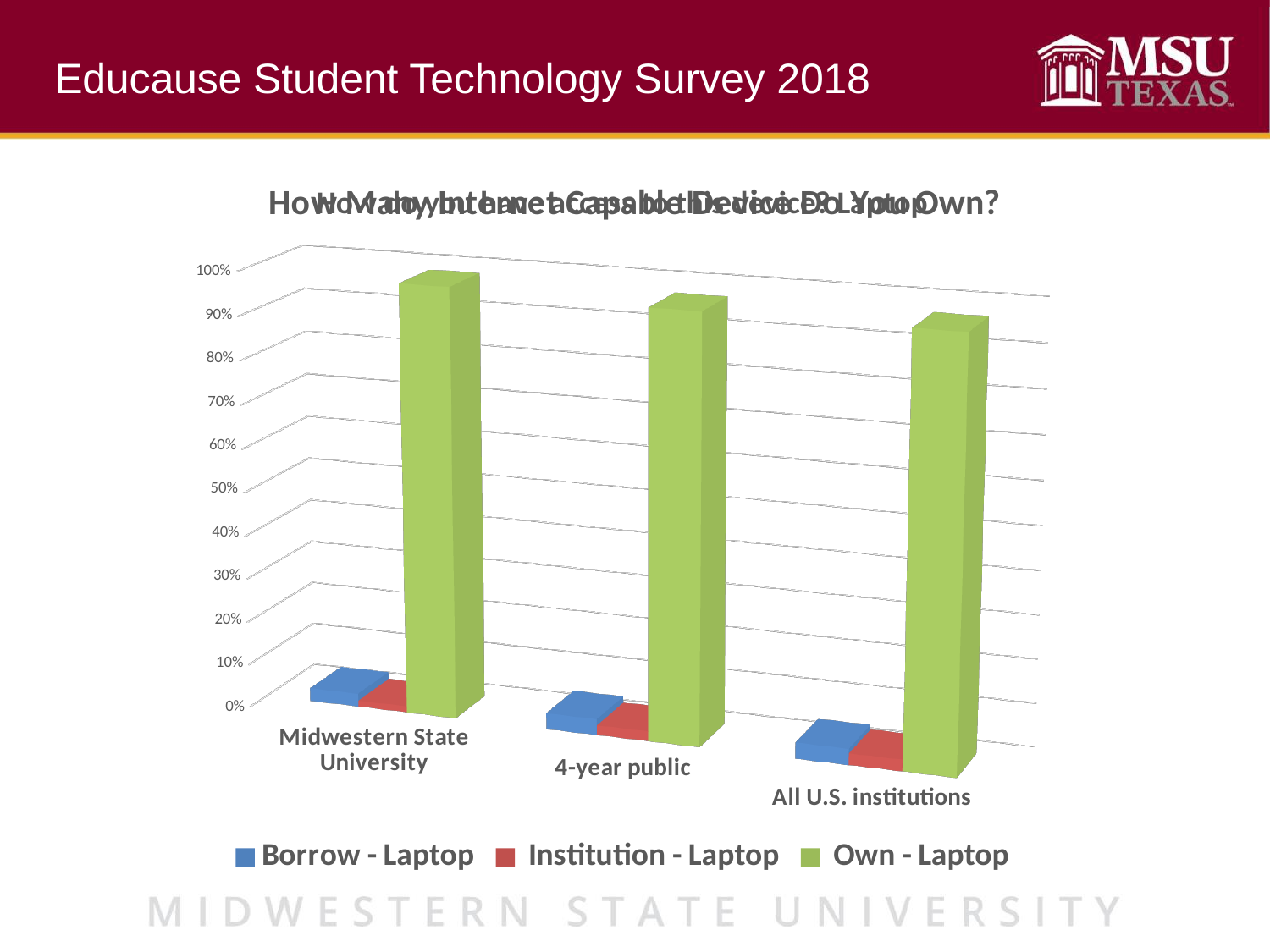
How many series does the chart's legend list? 3 Is the Own - Laptop value for All U.S. institutions greater or less than 80%? greater How many categories are shown on the x axis of the chart? 3 What kind of chart is shown on the slide? bar chart Do the Own - Laptop values rise or fall moving from left to right across the categories? fall Is the Own - Laptop value for Midwestern State University greater or less than 90%? greater Which has the larger Own - Laptop value: Midwestern State University or All U.S. institutions? Midwestern State University Which category has the highest value for Own - Laptop? Midwestern State University Which is larger for 4-year public: Own - Laptop or Borrow - Laptop? Own - Laptop Is the Borrow - Laptop value for Midwestern State University greater or less than 10%? less What colour represents the Own - Laptop series in the chart? green